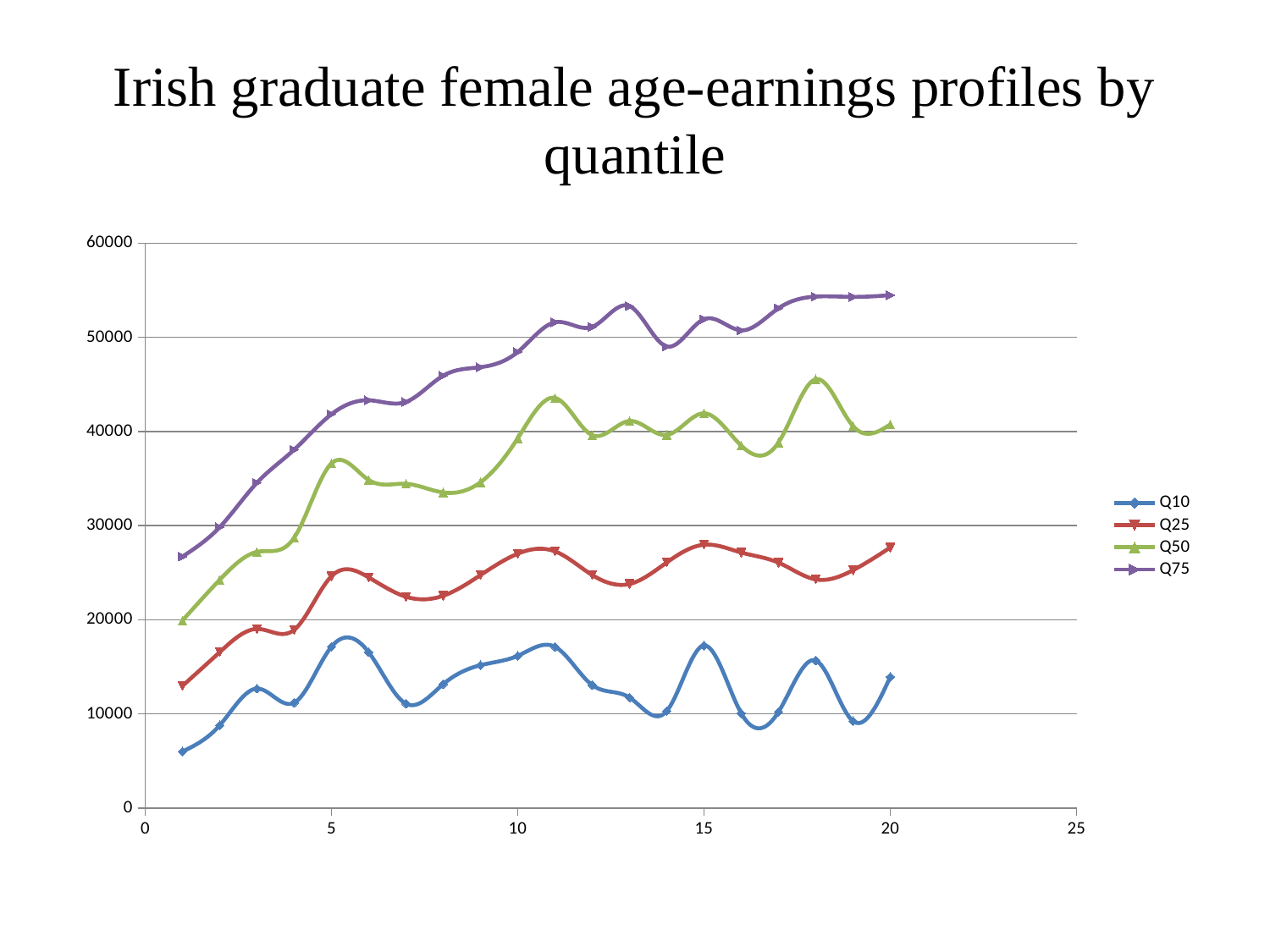
What is the title of the chart on the slide? Irish graduate female age-earnings profiles by quantile Which series has the highest values across the chart? Q75 What are the series names listed in the legend? Q10, Q25, Q50, Q75 Is the value for Q75 at x = 1 greater or less than 30000? less What kind of chart is shown on the slide? line chart How many series does the legend list? 4 Is the value for Q50 at x = 18 greater or less than 40000? greater Is the value for Q75 at x = 20 greater or less than 50000? greater Which series has the lowest values across the chart? Q10 Does the Q75 series generally rise or fall as x increases from 1 to 20? rise